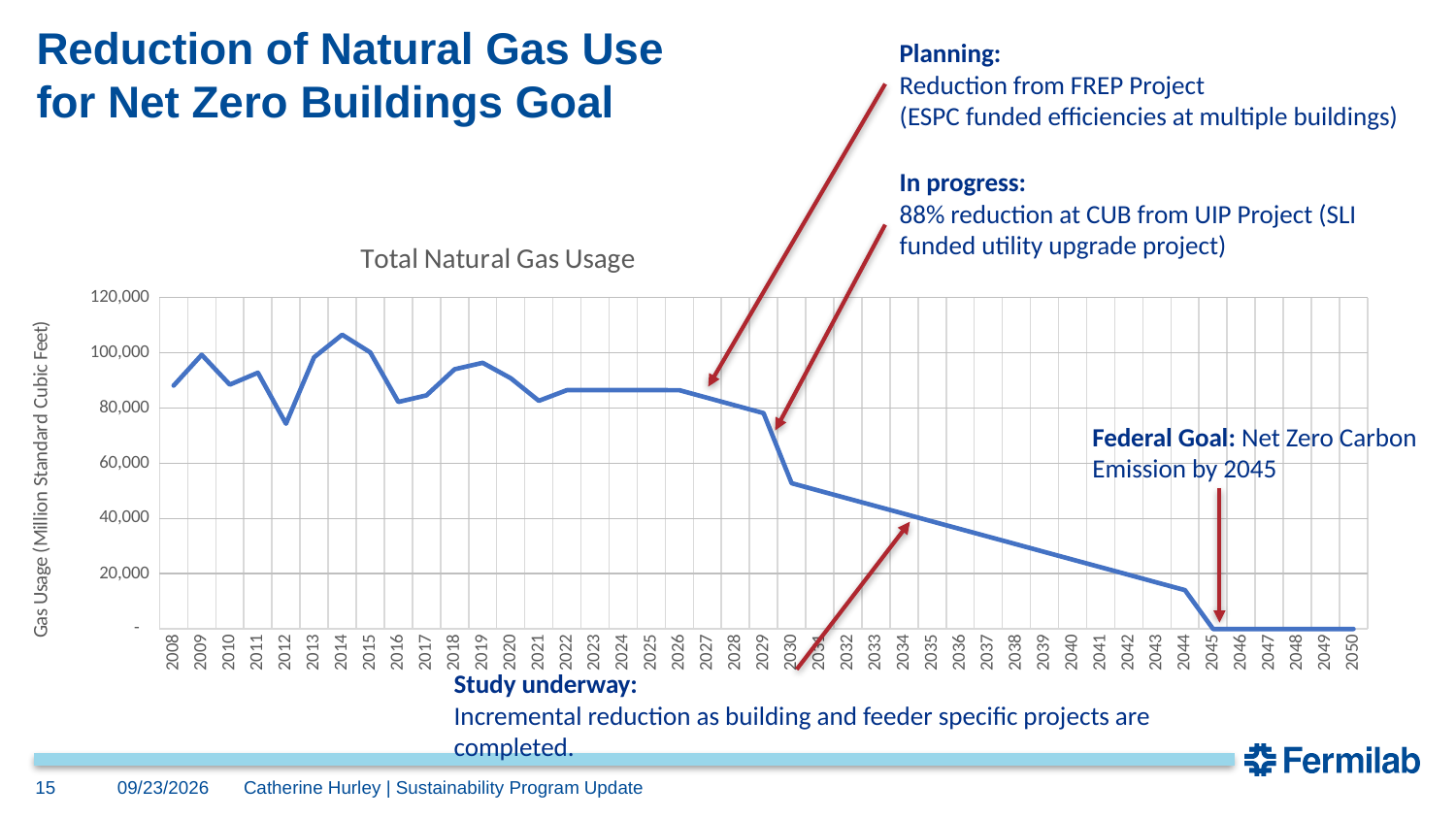
Is the value for 2012 greater or less than 80,000? less What is the label of the vertical axis of the chart? Gas Usage (Million Standard Cubic Feet) In which year is the total natural gas usage highest? 2014 Is the value for 2014 greater or less than 100,000? greater How many years are shown along the x axis of the chart? 43 Which year has the larger value, 2009 or 2014? 2014 What is the title of the chart? Total Natural Gas Usage Is the value for 2030 greater or less than 60,000? less Do the values rise or fall along the x axis from 2030 to 2045? fall What kind of chart is shown on the slide? line chart From which year onward does the line sit at zero? 2045